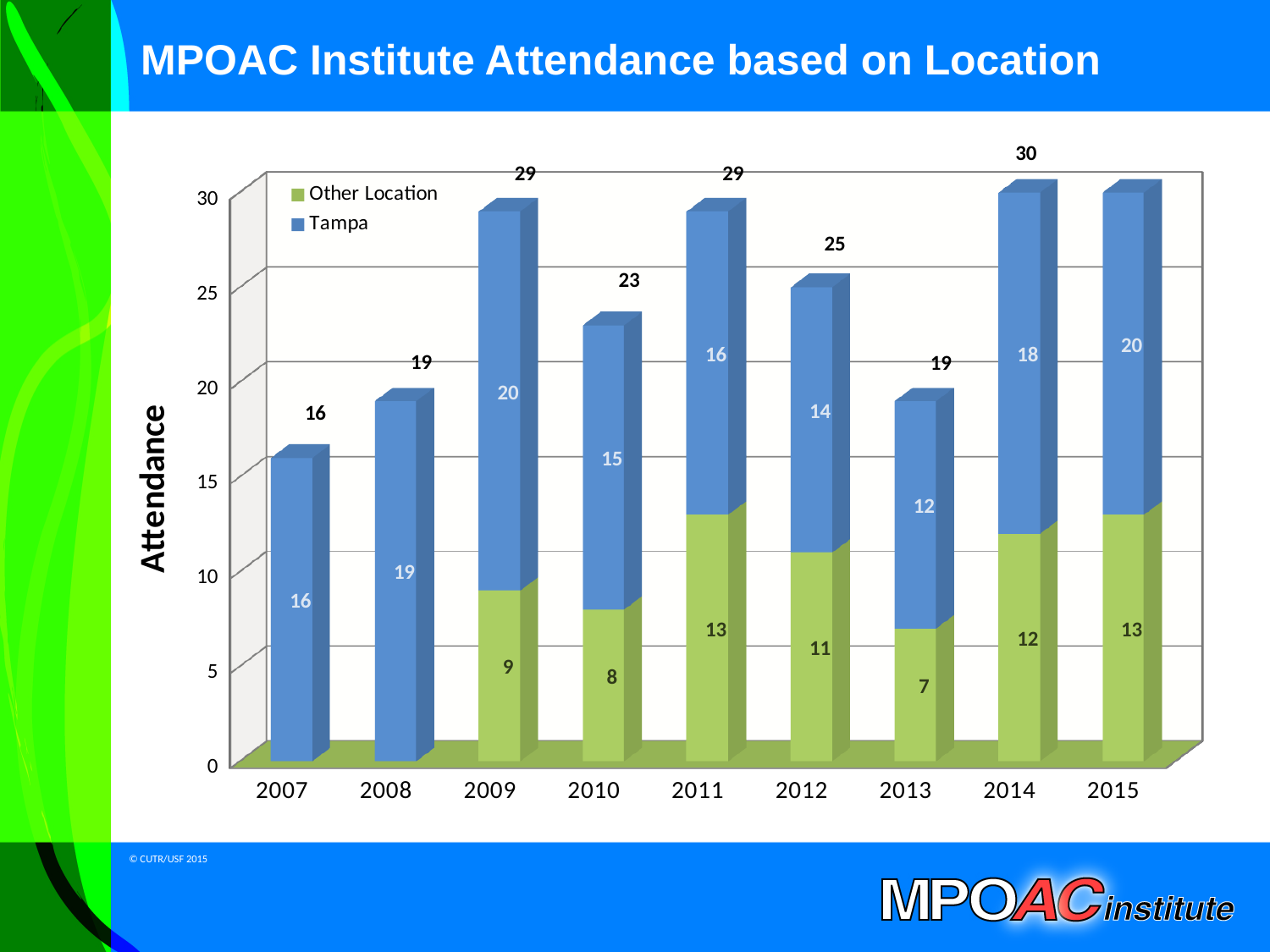
What is the Other Location attendance value for 2013? 7 How many series does the legend list? 2 What is the difference between the Tampa value and the Other Location value in 2011? 3 What is the total attendance shown for 2010? 23 What kind of chart is shown on the slide? stacked bar chart How many years are shown on the x axis? 9 Which series is shown in green in the legend? Other Location What is the Tampa attendance value for 2009? 20 Which is larger, the Tampa value for 2008 or the Tampa value for 2013? Tampa value for 2008 Is the total attendance for 2012 greater or less than 20? greater Which year has the lowest total attendance? 2007 What is the total attendance shown for 2014? 30